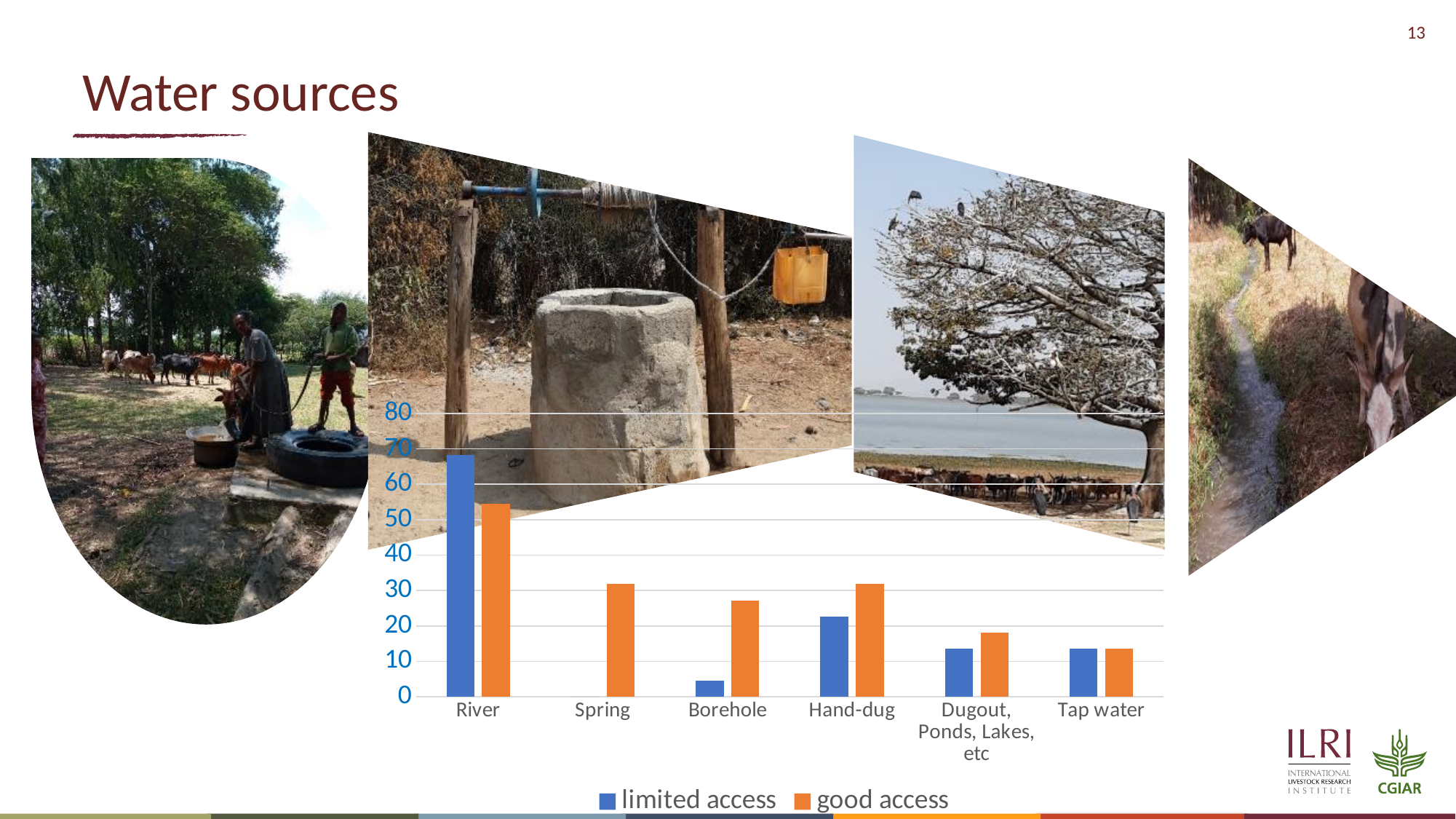
Which water source has the highest value for limited access? River For Borehole, which is larger: limited access or good access? good access Is the limited access value for Borehole greater or less than 10? less How many water source categories are shown on the x axis? 6 What are the two legend entries of the chart? limited access, good access For River, which is larger: limited access or good access? limited access What kind of chart is shown on the slide? bar chart Is the good access value for Spring greater or less than 40? less Which water source has the lowest good access value? Tap water Is the limited access value for River greater or less than 60? greater Which water source has the highest value for good access? River How many series does the legend list? 2